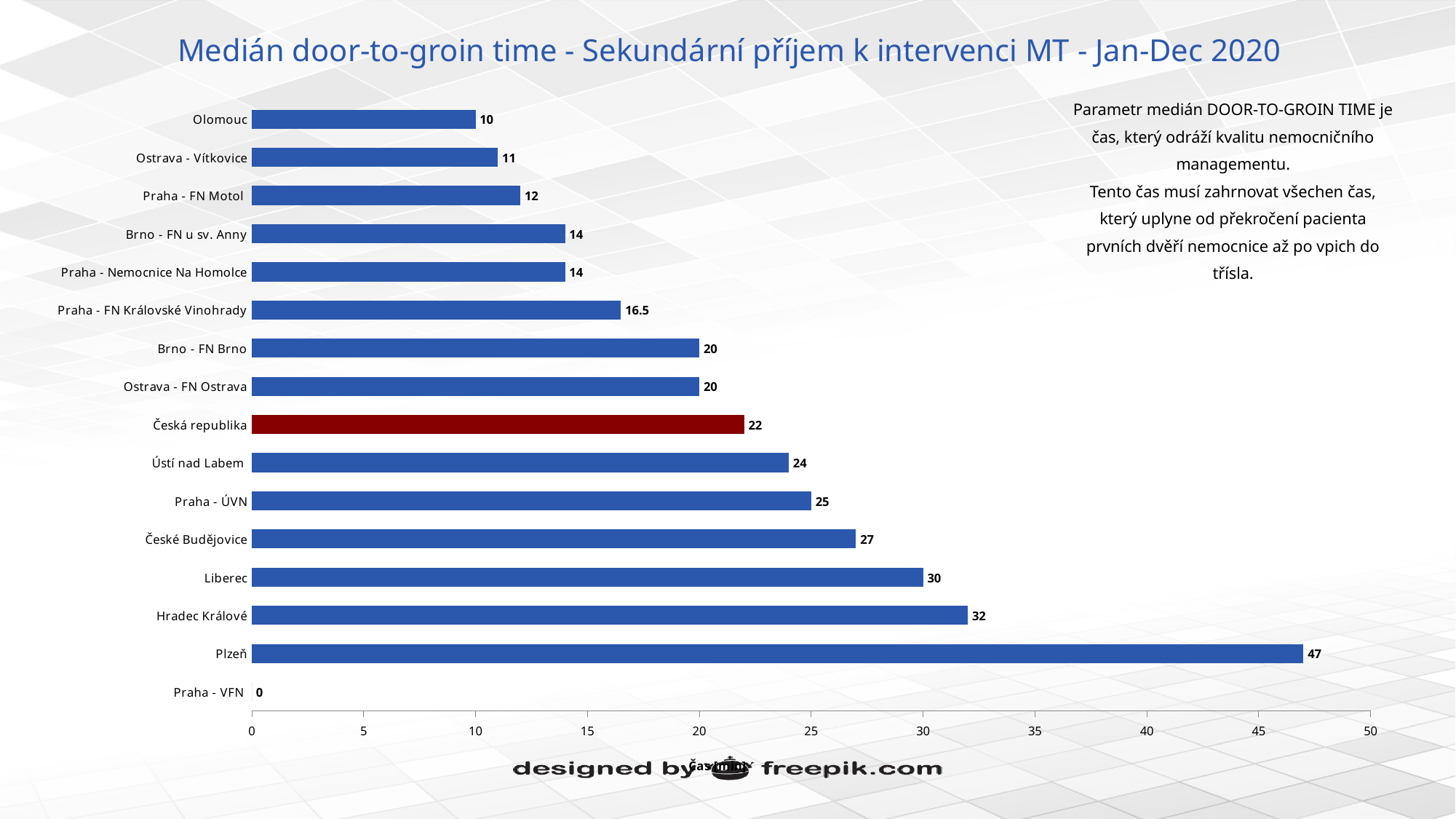
What kind of chart is shown on the slide? Bar chart What is the difference between the values for Hradec Králové and Liberec? 2 What is the median door-to-groin time for Plzeň? 47 Which has a larger value, Ústí nad Labem or Praha - ÚVN? Praha - ÚVN Which category has the highest value on the chart? Plzeň What is the value shown for Česká republika? 22 How many categories are shown on the chart? 16 Which category has the lowest value on the chart? Praha - VFN Which category's bar is coloured dark red instead of blue? Česká republika Is the value for České Budějovice greater or less than 25? greater What is the value shown for Olomouc? 10 What is the value shown for Praha - FN Královské Vinohrady? 16.5